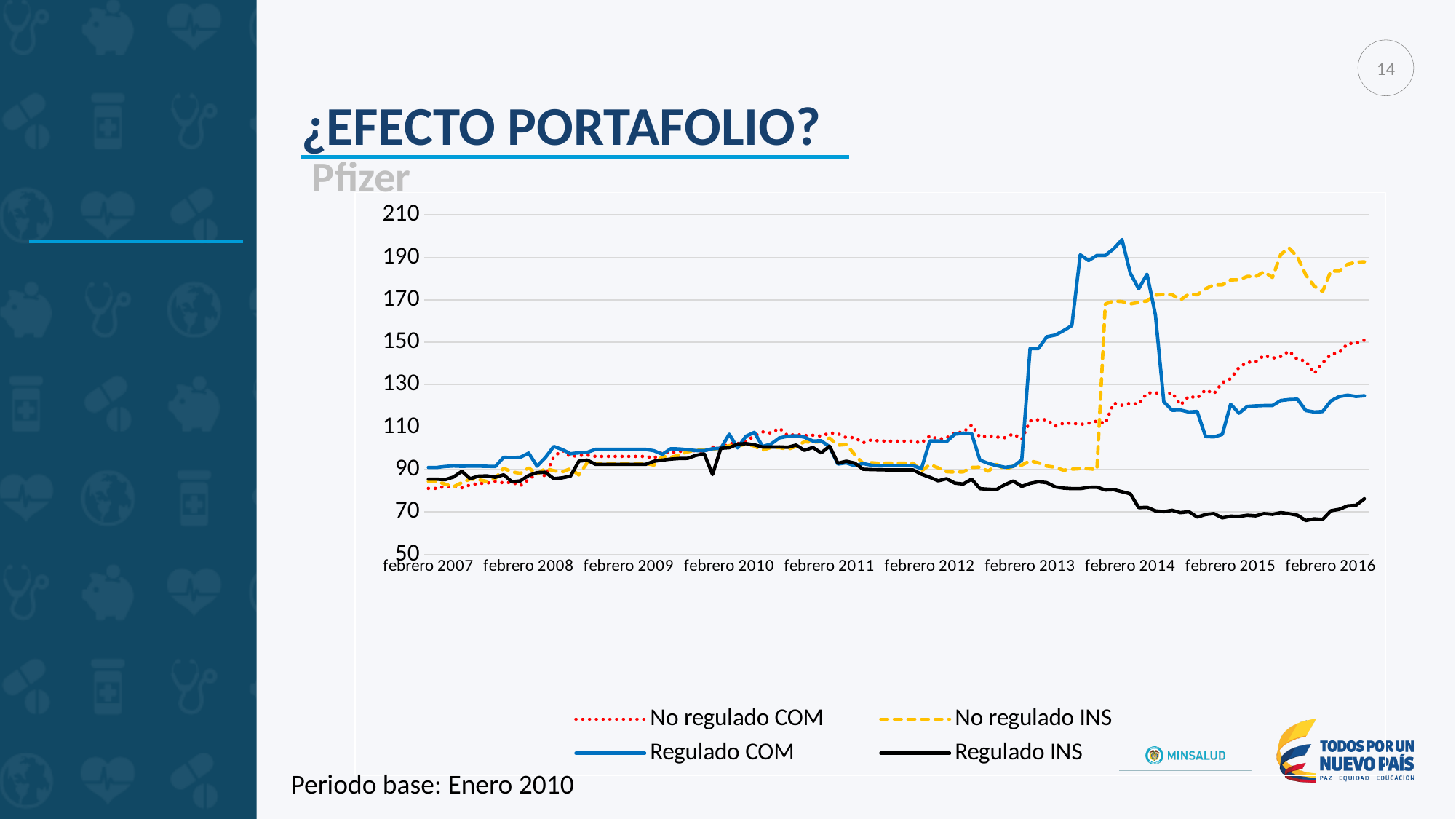
Which series has the highest value at febrero 2016? No regulado INS Which series has the lowest value at febrero 2016? Regulado INS How many series does the legend list? 4 Is the highest value reached by Regulado COM greater or less than 190? greater Is the value for No regulado COM at febrero 2016 greater or less than 130? greater Which series is drawn as a solid blue line? Regulado COM Is the value for Regulado INS at febrero 2016 greater or less than 90? less What is the title of the chart? Pfizer How many date labels are shown on the x axis? 10 Does the Regulado INS series rise or fall between febrero 2012 and febrero 2015? fall What kind of chart is shown on the slide? line chart